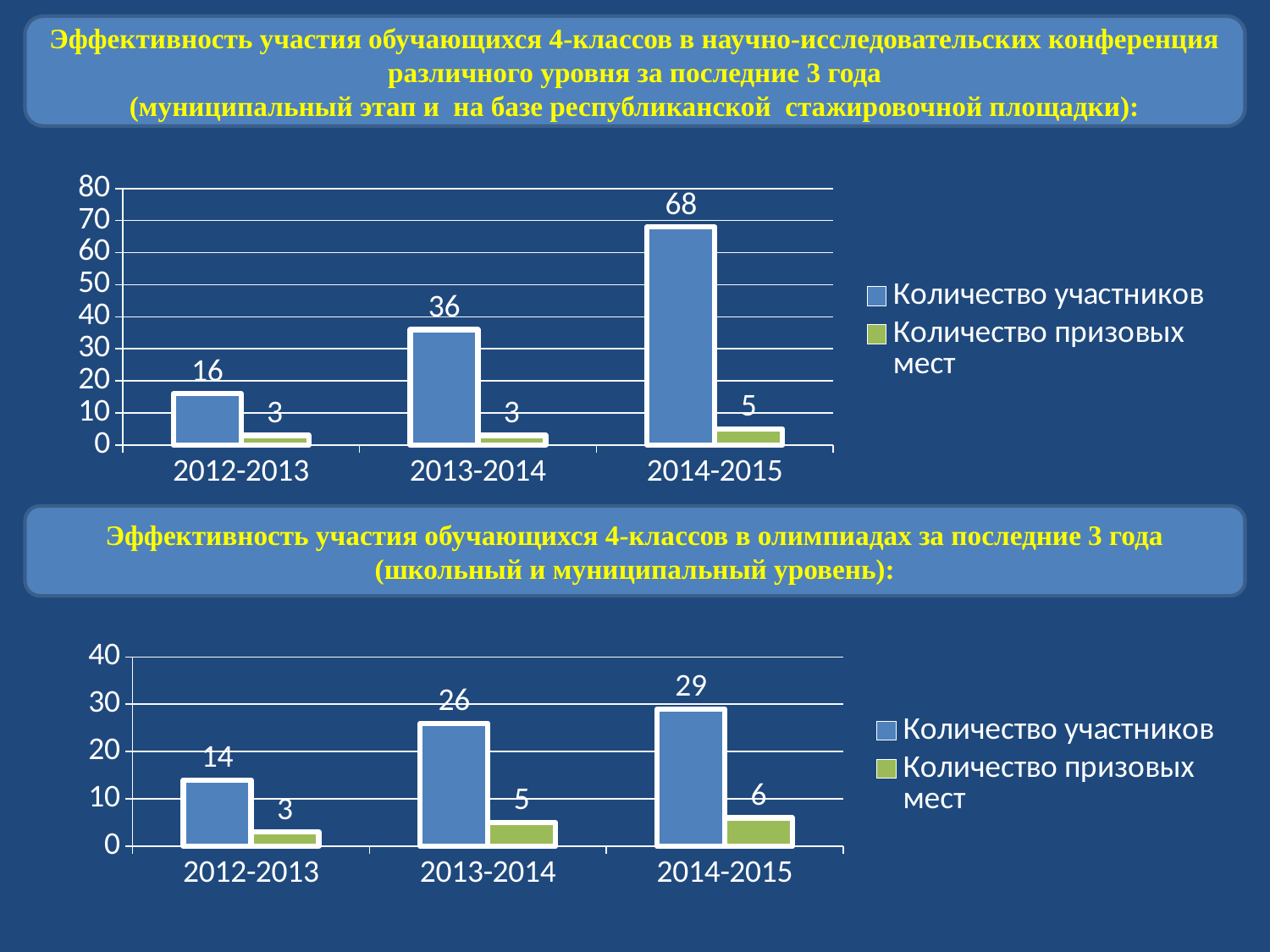
In the top chart (conferences), does Количество участников rise or fall from 2012-2013 to 2014-2015? rise In the top chart (conferences), what is the difference between Количество участников in 2014-2015 and 2013-2014? 32 In the top chart (conferences), what is the value of Количество призовых мест for 2012-2013? 3 In the bottom chart (olympiads), which year has the lowest Количество призовых мест? 2012-2013 What type of chart is the bottom chart (olympiads)? bar chart In the top chart (conferences), which year has the highest Количество участников? 2014-2015 In the top chart (conferences), what is the value of Количество участников for 2014-2015? 68 In the bottom chart (olympiads), what is the difference between Количество участников and Количество призовых мест in 2012-2013? 11 In the bottom chart (olympiads), what is the value of Количество призовых мест for 2014-2015? 6 In the bottom chart (olympiads), what is the value of Количество участников for 2013-2014? 26 In the top chart (conferences), how many series does the legend list? 2 In the bottom chart (olympiads), how many year categories are shown on the x axis? 3